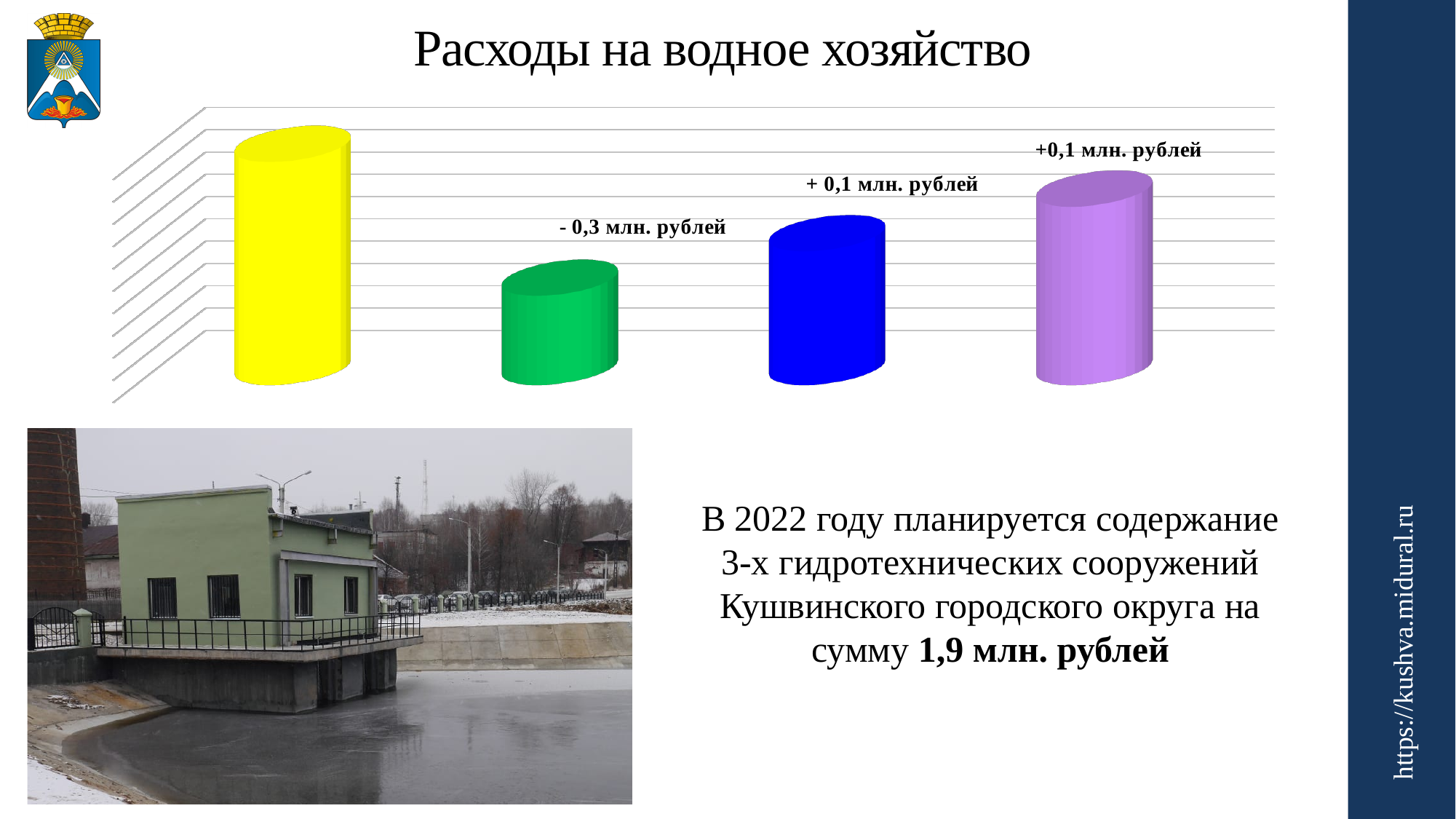
Which is taller, the third (blue) bar or the fourth (purple) bar? the fourth (purple) bar Which is taller, the first (yellow) bar or the second (green) bar? the first (yellow) bar Which bar in the chart is the tallest? the first (yellow) bar What change is annotated above the fourth (purple) bar? +0,1 млн. рублей Which bar in the chart is the shortest? the second (green) bar What is the title of the chart on the slide? Расходы на водное хозяйство What change is annotated above the second (green) bar? - 0,3 млн. рублей From the second bar to the fourth bar, do the values rise or fall? rise What colour is the third bar in the chart? blue How many bars does the chart contain? 4 What kind of chart is shown on the slide? bar chart What change is annotated above the third (blue) bar? + 0,1 млн. рублей